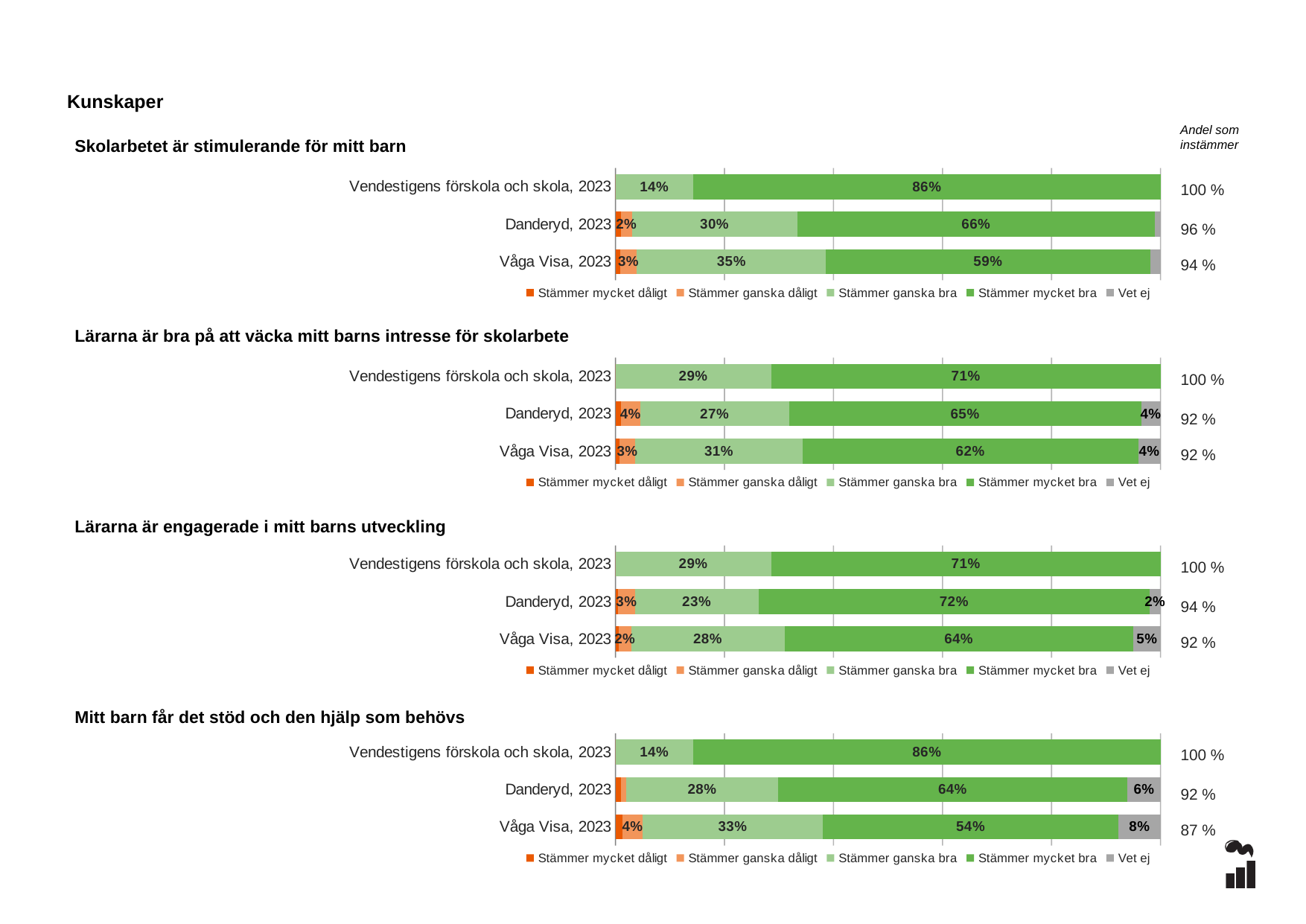
In the chart 'Lärarna är engagerade i mitt barns utveckling', what is the 'Vet ej' value for Våga Visa, 2023? 5% In the chart 'Mitt barn får det stöd och den hjälp som behövs', what is the 'Vet ej' value for Danderyd, 2023? 6% In the chart 'Mitt barn får det stöd och den hjälp som behövs', is the 'Stämmer mycket bra' value larger for Danderyd, 2023 or Våga Visa, 2023? Danderyd, 2023 In the chart 'Lärarna är engagerade i mitt barns utveckling', what is the difference between the 'Stämmer mycket bra' values for Danderyd, 2023 and Våga Visa, 2023? 8% In the chart 'Lärarna är bra på att väcka mitt barns intresse för skolarbete', what is the 'Stämmer ganska bra' value for Våga Visa, 2023? 31% How many rows (categories) are shown in the chart 'Lärarna är engagerade i mitt barns utveckling'? 3 In the chart 'Skolarbetet är stimulerande för mitt barn', what is the 'Stämmer mycket bra' value for Vendestigens förskola och skola, 2023? 86% In the chart 'Skolarbetet är stimulerande för mitt barn', what is the 'Andel som instämmer' for Danderyd, 2023? 96 % In the chart 'Mitt barn får det stöd och den hjälp som behövs', which row has the lowest 'Andel som instämmer'? Våga Visa, 2023 In the chart 'Lärarna är bra på att väcka mitt barns intresse för skolarbete', which row has the highest 'Stämmer mycket bra' value? Vendestigens förskola och skola, 2023 What kind of chart is used for 'Skolarbetet är stimulerande för mitt barn'? Stacked bar chart How many series does the legend list in the chart 'Skolarbetet är stimulerande för mitt barn'? 5